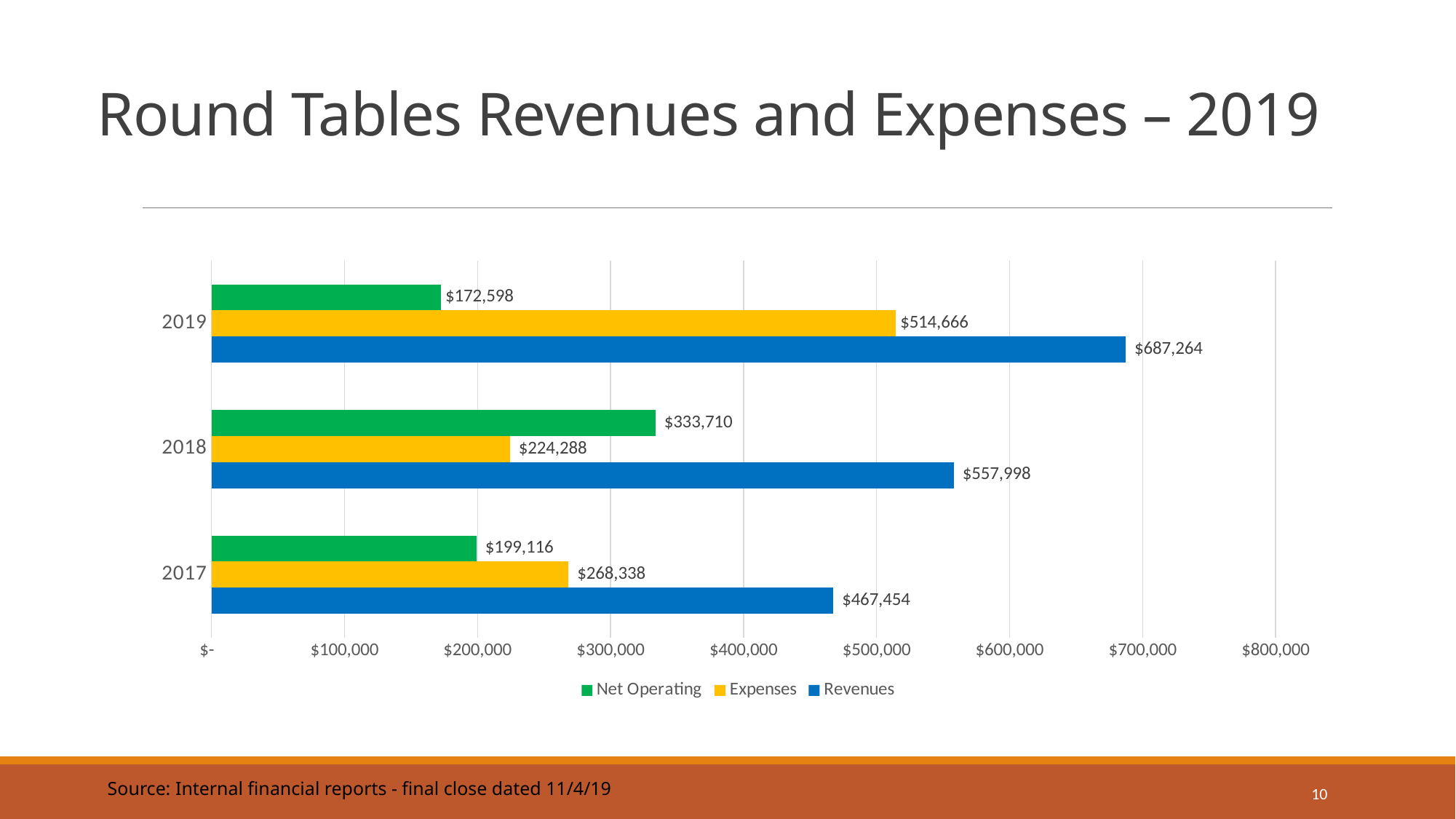
How many years are shown on the chart? 3 What is the Net Operating value for 2017? $199,116 Which year has the highest Revenues? 2019 How many series does the legend list? 3 Which is larger in 2018, Net Operating or Expenses? Net Operating What is the difference between Revenues and Expenses in 2019? $172,598 What is the Expenses value for 2018? $224,288 What kind of chart is shown on the slide? Bar chart Which year has the lowest Net Operating value? 2019 Is the Expenses value for 2019 greater or less than $500,000? greater What is the Revenues value for 2019? $687,264 Which colour represents Expenses in the chart? Yellow